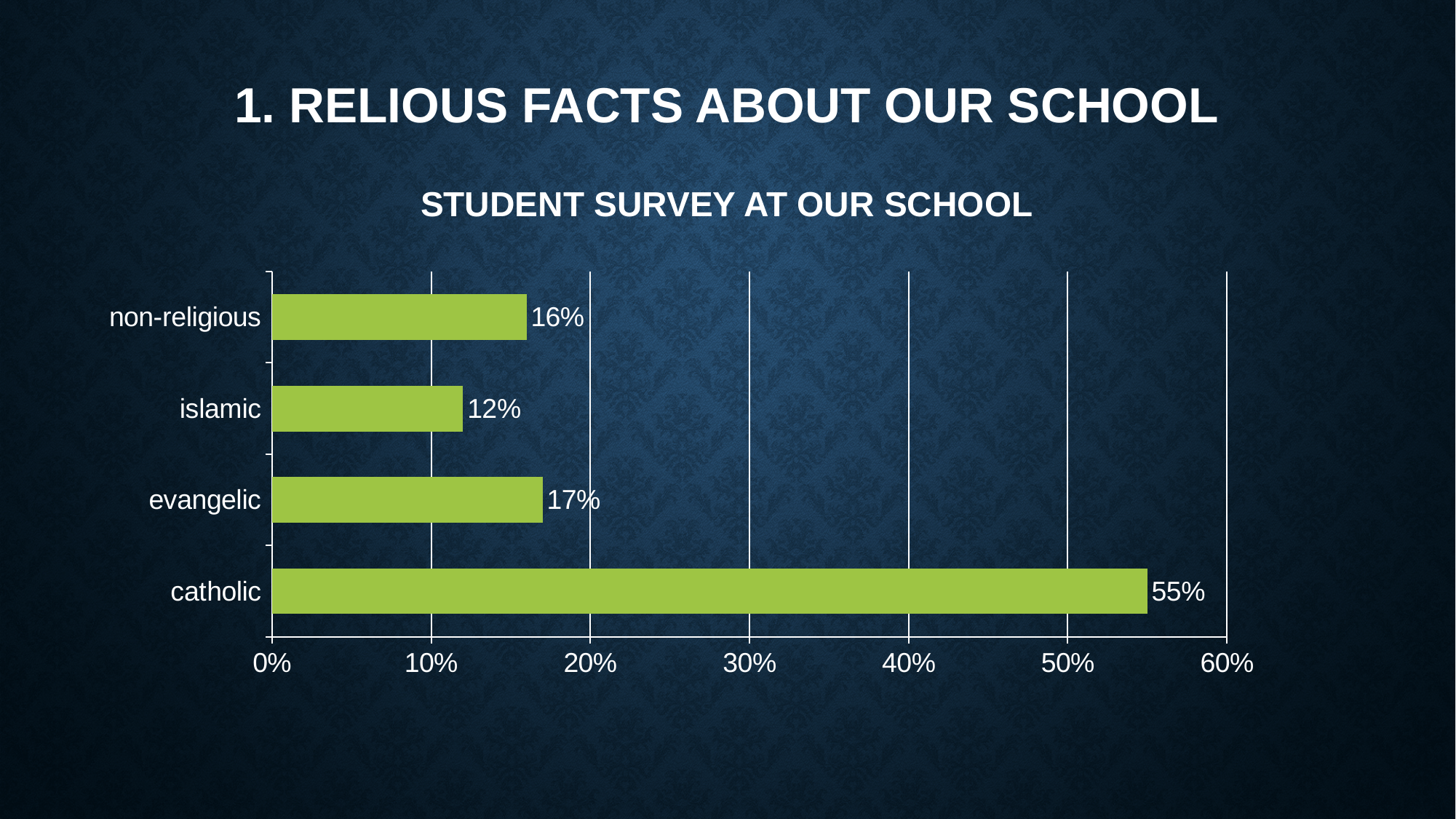
Which category has the lowest value? islamic What is the value for islamic? 12% What is the difference between the values for non-religious and islamic? 4% How many categories are shown in the chart? 4 What is the value for catholic? 55% What is the value for evangelic? 17% What is the difference between the values for catholic and evangelic? 38% Which is larger, the value for evangelic or the value for islamic? evangelic What kind of chart is shown on the slide? bar chart Which category has the highest value? catholic What is the value for non-religious? 16% Is the value for catholic greater or less than 50%? greater